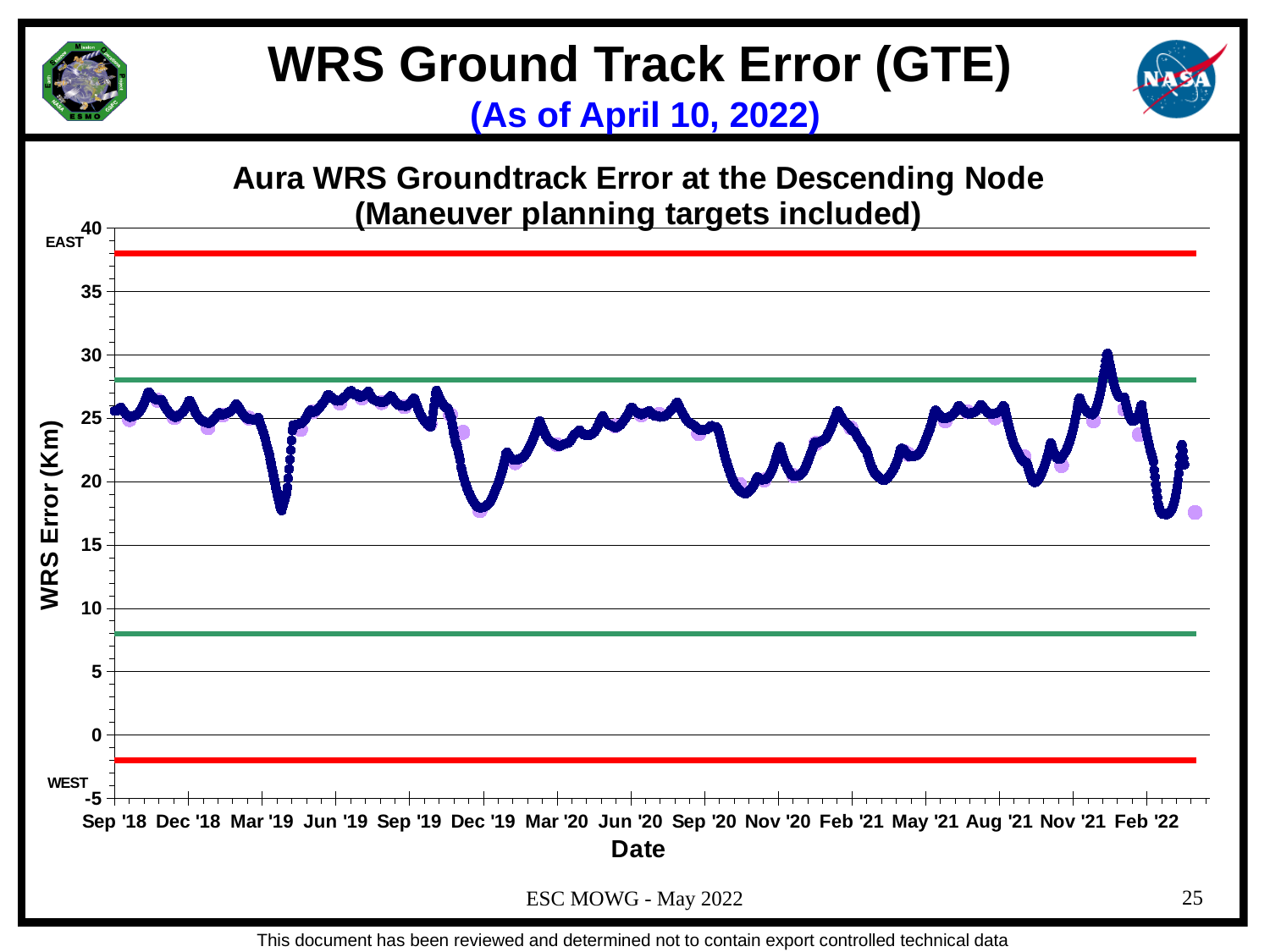
Is the lowest point of the dip near Mar '19 greater or less than 20? less Is the plotted value at Feb '21 greater or less than 20? greater What is the highest value shown on the vertical axis? 40 Is the peak of the plotted line between Nov '21 and Feb '22 greater or less than 25? greater Between which two horizontal-axis labels does the plotted line reach its highest value? Nov '21 and Feb '22 What is the label of the vertical axis? WRS Error (Km) What is the lowest value shown on the vertical axis? -5 What is the title of the chart? Aura WRS Groundtrack Error at the Descending Node (Maneuver planning targets included) What kind of chart is shown on the slide? line chart How many date labels are shown along the horizontal axis? 15